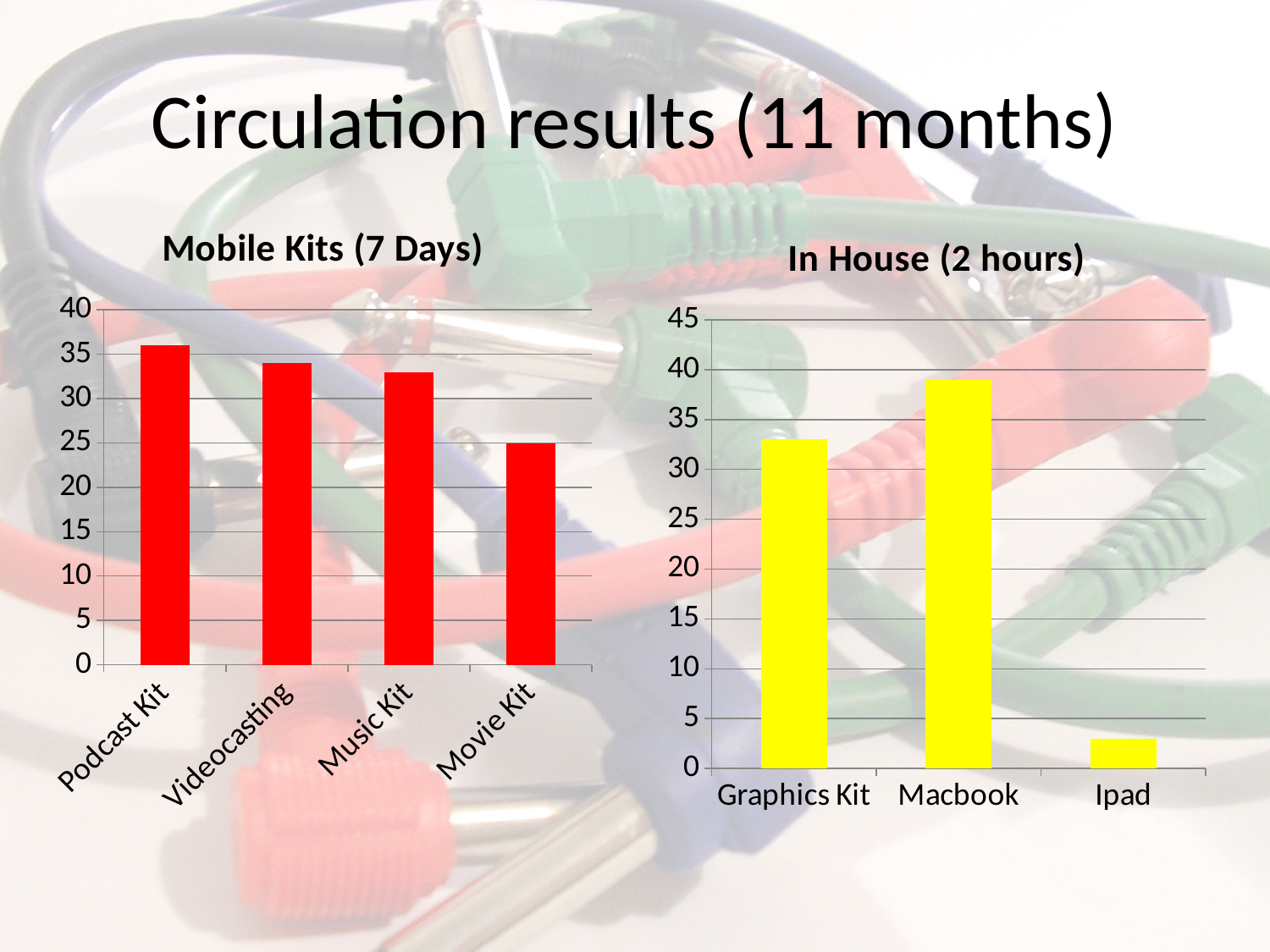
How many categories are shown in the 'Mobile Kits (7 Days)' chart? 4 In the 'Mobile Kits (7 Days)' chart, which category has the highest value? Podcast Kit What colour are the bars in the 'In House (2 hours)' chart? yellow In the 'Mobile Kits (7 Days)' chart, which category has the lowest value? Movie Kit In the 'In House (2 hours)' chart, which category has the highest value? Macbook In the 'Mobile Kits (7 Days)' chart, do the values rise or fall from Podcast Kit to Movie Kit? fall In the 'In House (2 hours)' chart, which category has the lowest value? Ipad In the 'Mobile Kits (7 Days)' chart, is the value for Movie Kit greater or less than 30? less In the 'In House (2 hours)' chart, which is larger, Macbook or Graphics Kit? Macbook In the 'In House (2 hours)' chart, is the value for Ipad greater or less than 5? less What kind of chart is the 'Mobile Kits (7 Days)' chart? bar chart How many categories are shown in the 'In House (2 hours)' chart? 3